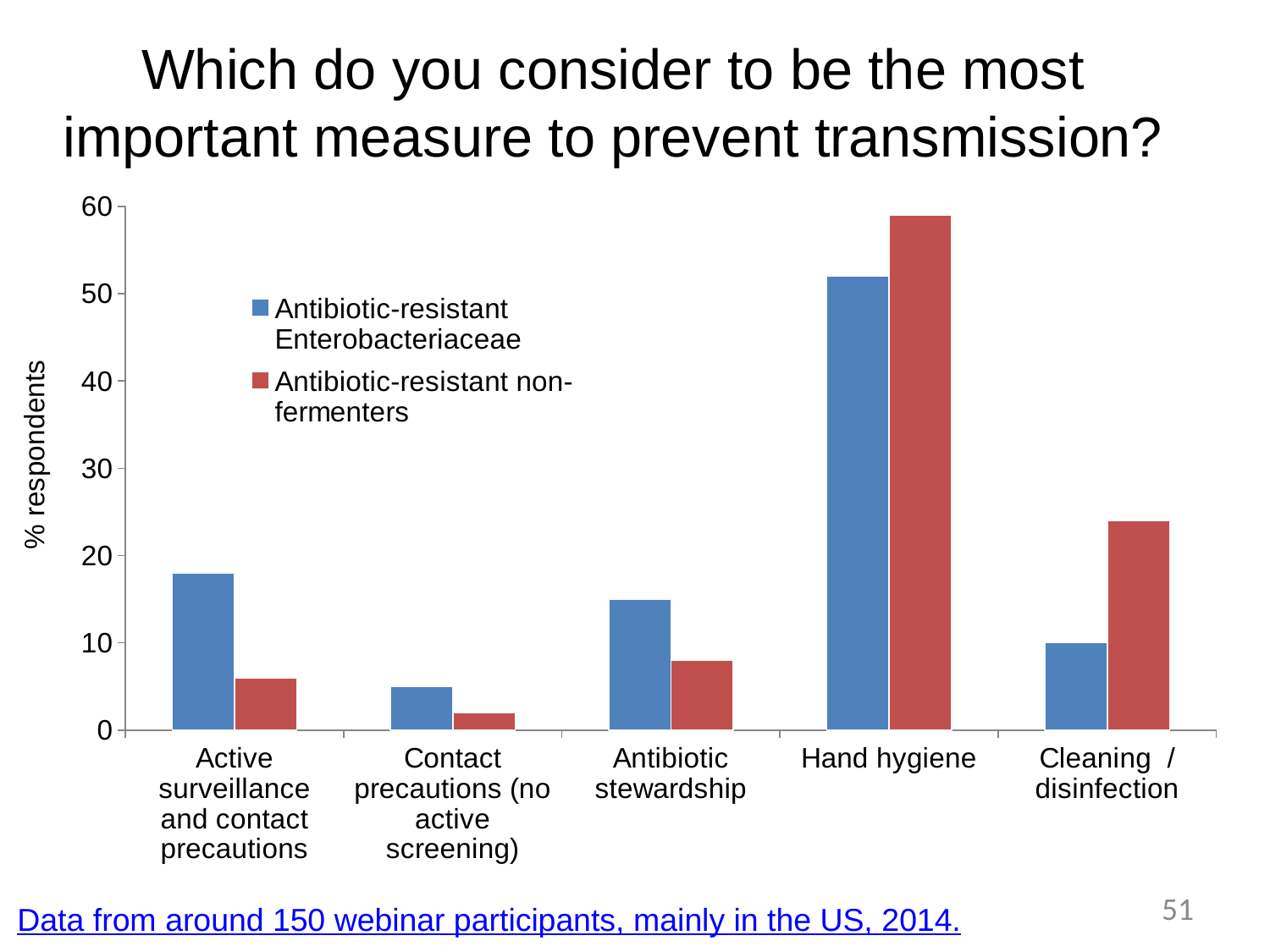
Which category has the lowest value for Antibiotic-resistant non-fermenters? Contact precautions (no active screening) How many categories are shown on the x axis? 5 Which category has the highest value for Antibiotic-resistant non-fermenters? Hand hygiene Is the value for Hand hygiene for Antibiotic-resistant non-fermenters greater or less than 50? greater For Cleaning / disinfection, which series has the larger value: Antibiotic-resistant Enterobacteriaceae or Antibiotic-resistant non-fermenters? Antibiotic-resistant non-fermenters For Antibiotic stewardship, which series has the larger value: Antibiotic-resistant Enterobacteriaceae or Antibiotic-resistant non-fermenters? Antibiotic-resistant Enterobacteriaceae How many series does the legend list? 2 Which category has the lowest value for Antibiotic-resistant Enterobacteriaceae? Contact precautions (no active screening) What kind of chart is shown on the slide? bar chart Which category has the highest value for Antibiotic-resistant Enterobacteriaceae? Hand hygiene What is the label of the y axis? % respondents Is the value for Active surveillance and contact precautions for Antibiotic-resistant Enterobacteriaceae greater or less than 20? less